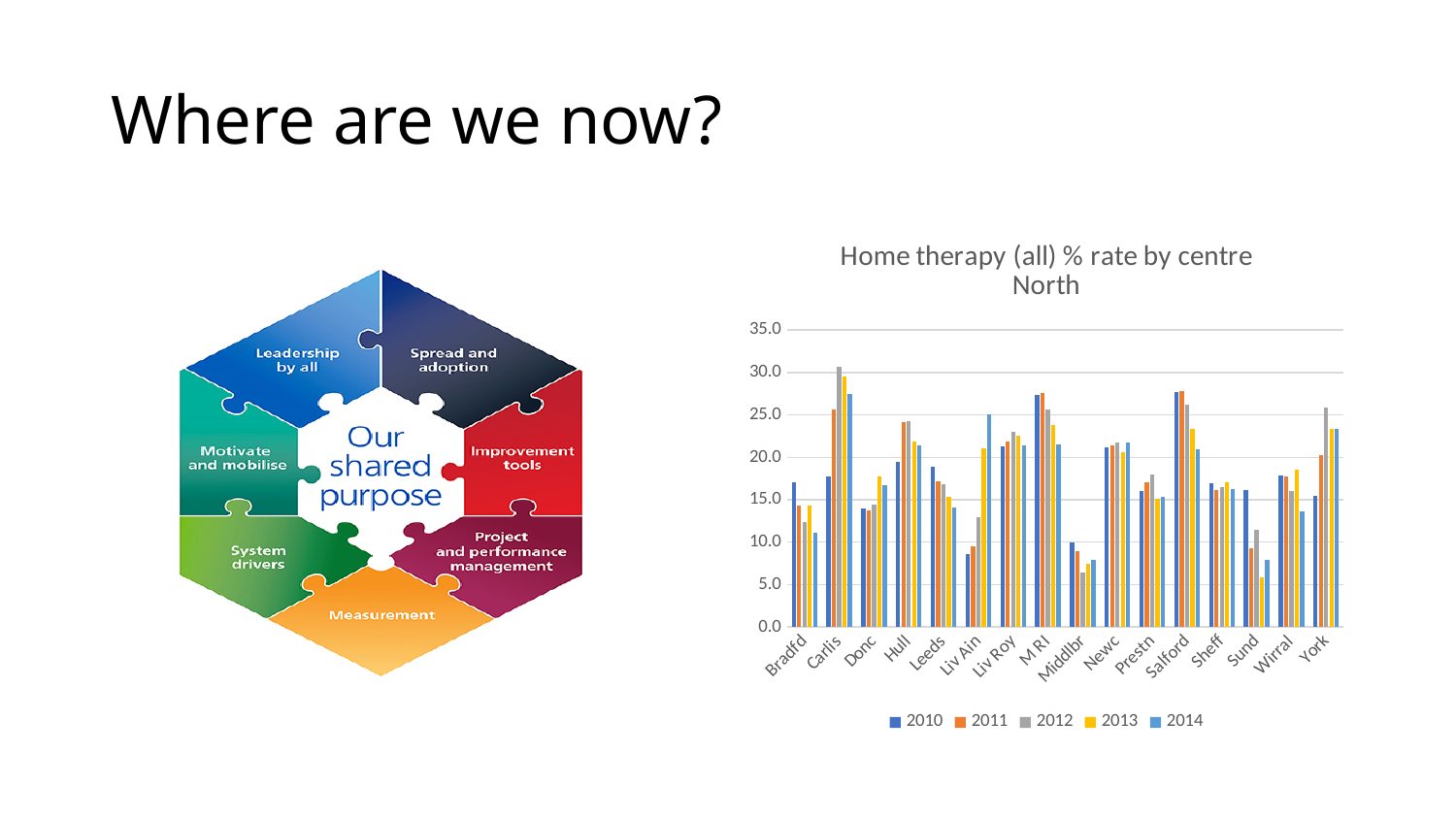
Is the 2012 value for Middlbr greater or less than 10? less How many centres are shown on the x axis of the chart? 16 What is the title of the chart? Home therapy (all) % rate by centre North Which centre has the highest 2012 value? Carlis Is the 2012 value for Carlis greater or less than 30? greater Is the 2010 value for Salford greater or less than 25? greater Which is larger, the 2011 value for Carlis or the 2011 value for Bradfd? Carlis What kind of chart is shown on the slide? bar chart Which years are listed in the chart legend? 2010, 2011, 2012, 2013, 2014 How many series does the chart legend list? 5